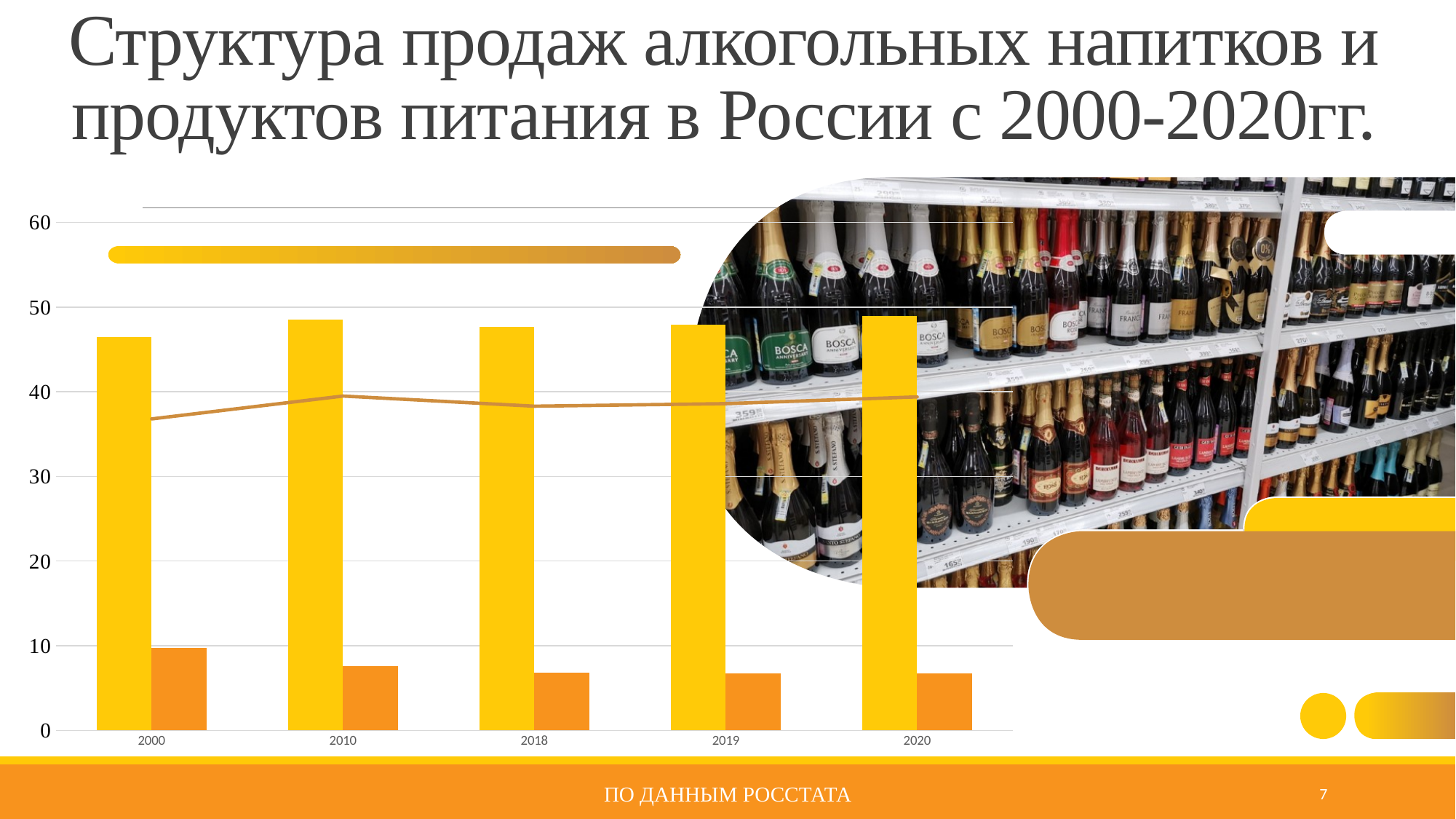
Which is larger, the orange bar for 2000 or the orange bar for 2010? 2000 Is the value of the yellow bar for 2000 greater or less than 40? greater Is the value of the line at 2000 greater or less than 40? less Which years are shown on the x axis of the chart? 2000, 2010, 2018, 2019, 2020 Which is larger for 2019, the yellow bar or the orange bar? the yellow bar Is the value of the orange bar for 2020 greater or less than 10? less In which year is the orange bar the highest? 2000 Do the orange bars generally rise or fall from 2000 to 2020? fall What kind of chart is shown on the slide? bar chart with a line How many years are shown on the x axis of the chart? 5